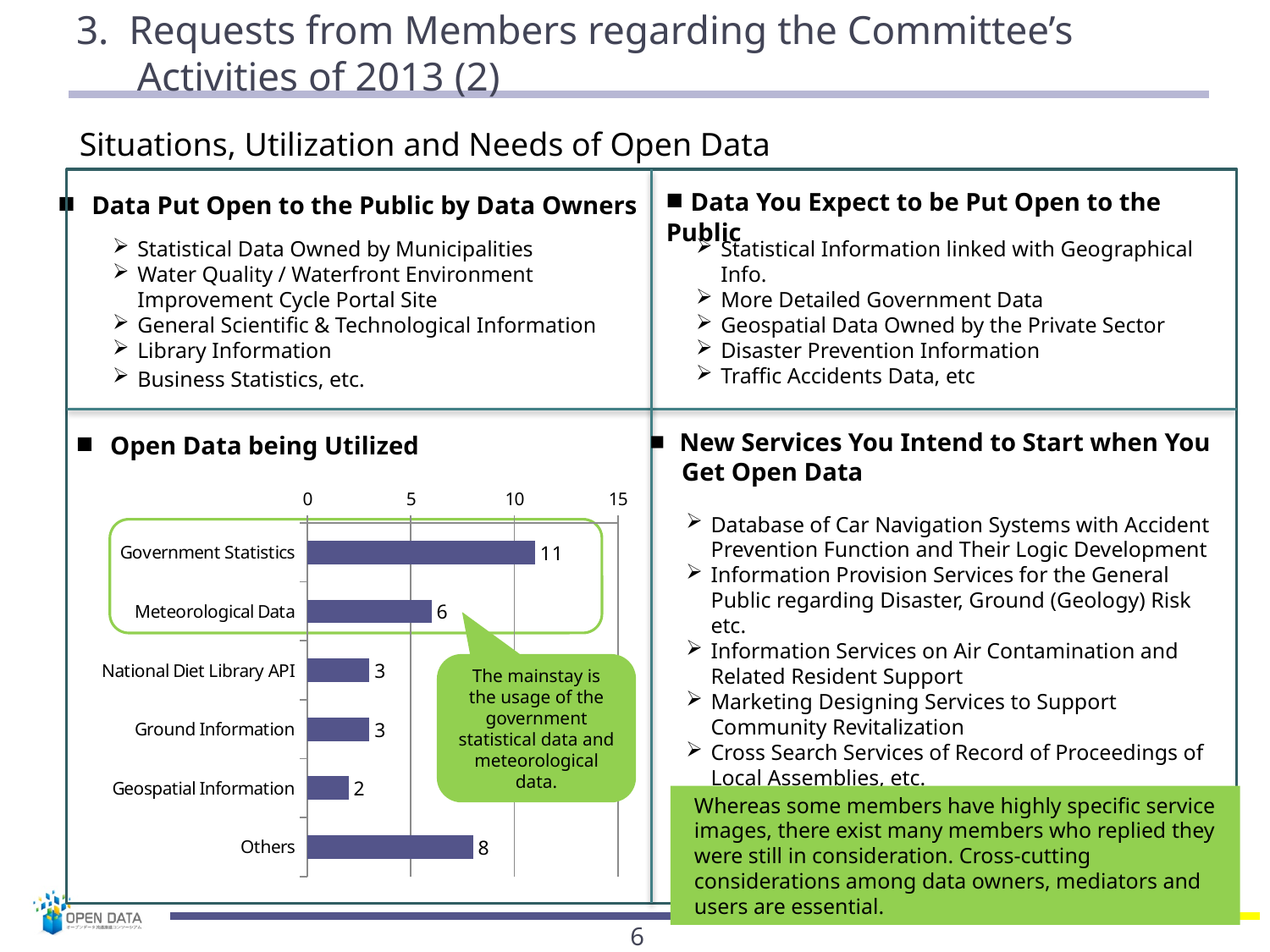
What is the difference between the values for Government Statistics and Meteorological Data in the Open Data being Utilized chart? 5 What kind of chart is the Open Data being Utilized chart? bar chart Which category has the highest value in the Open Data being Utilized chart? Government Statistics Which category has the lowest value in the Open Data being Utilized chart? Geospatial Information What is the value for Meteorological Data in the Open Data being Utilized chart? 6 How many categories are shown in the Open Data being Utilized chart? 6 What is the value for Geospatial Information in the Open Data being Utilized chart? 2 What is the maximum value shown on the axis of the Open Data being Utilized chart? 15 What is the value for Others in the Open Data being Utilized chart? 8 Is the value for Government Statistics in the Open Data being Utilized chart greater or less than 10? greater Which is larger in the Open Data being Utilized chart, Others or Meteorological Data? Others What is the value for Government Statistics in the Open Data being Utilized chart? 11